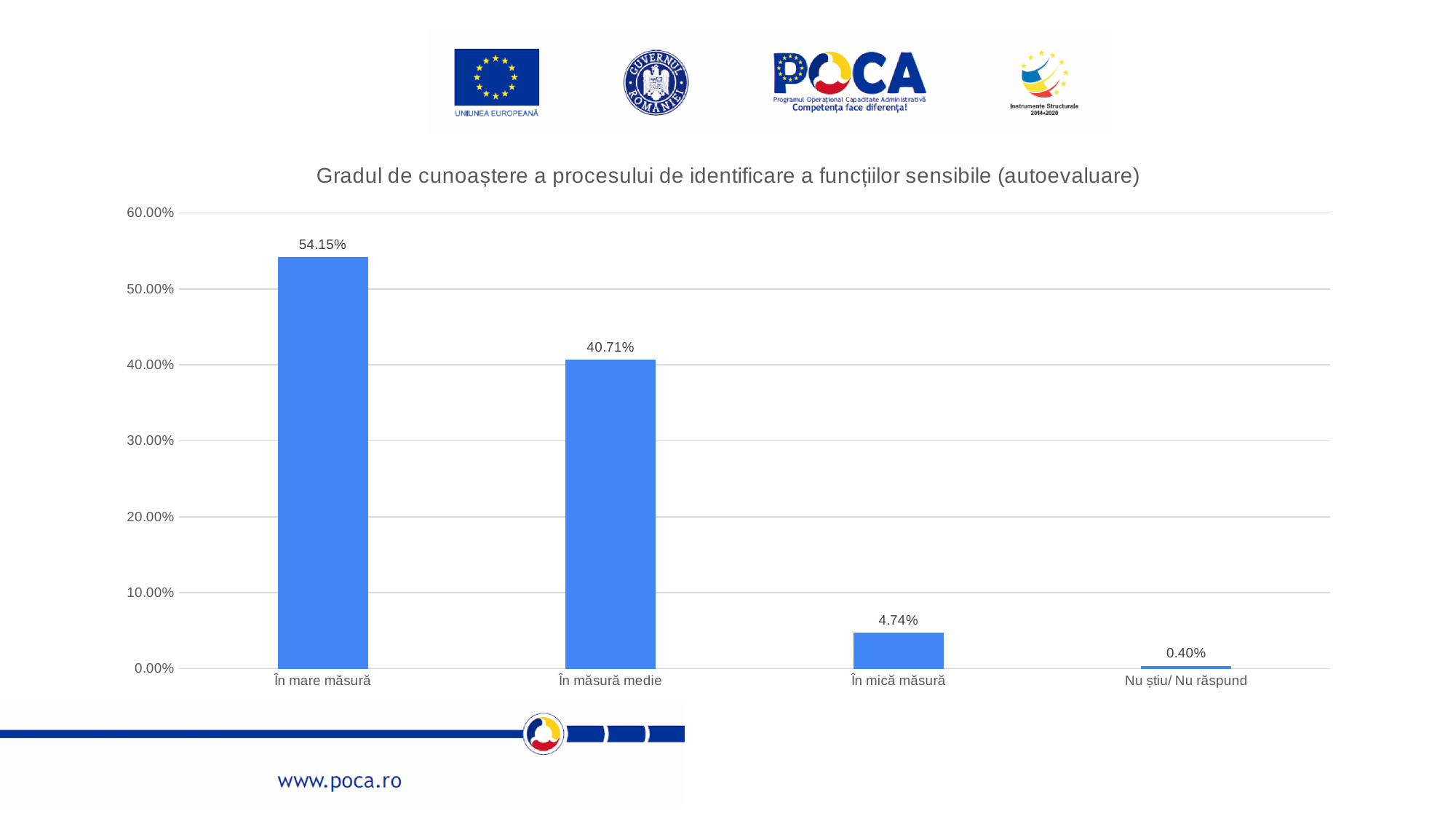
Which category has the lowest value? Nu știu/ Nu răspund Which is larger, the value for În măsură medie or the value for În mică măsură? În măsură medie What is the value for Nu știu/ Nu răspund? 0.40% What is the value for În mare măsură? 54.15% What is the difference between the values for În mare măsură and În măsură medie? 13.44% What is the title of the chart? Gradul de cunoaștere a procesului de identificare a funcțiilor sensibile (autoevaluare) Is the value for În mare măsură greater or less than 50.00%? greater What is the value for În măsură medie? 40.71% What kind of chart is shown on the slide? bar chart How many categories are shown on the x axis? 4 What is the value for În mică măsură? 4.74% Which category has the highest value? În mare măsură